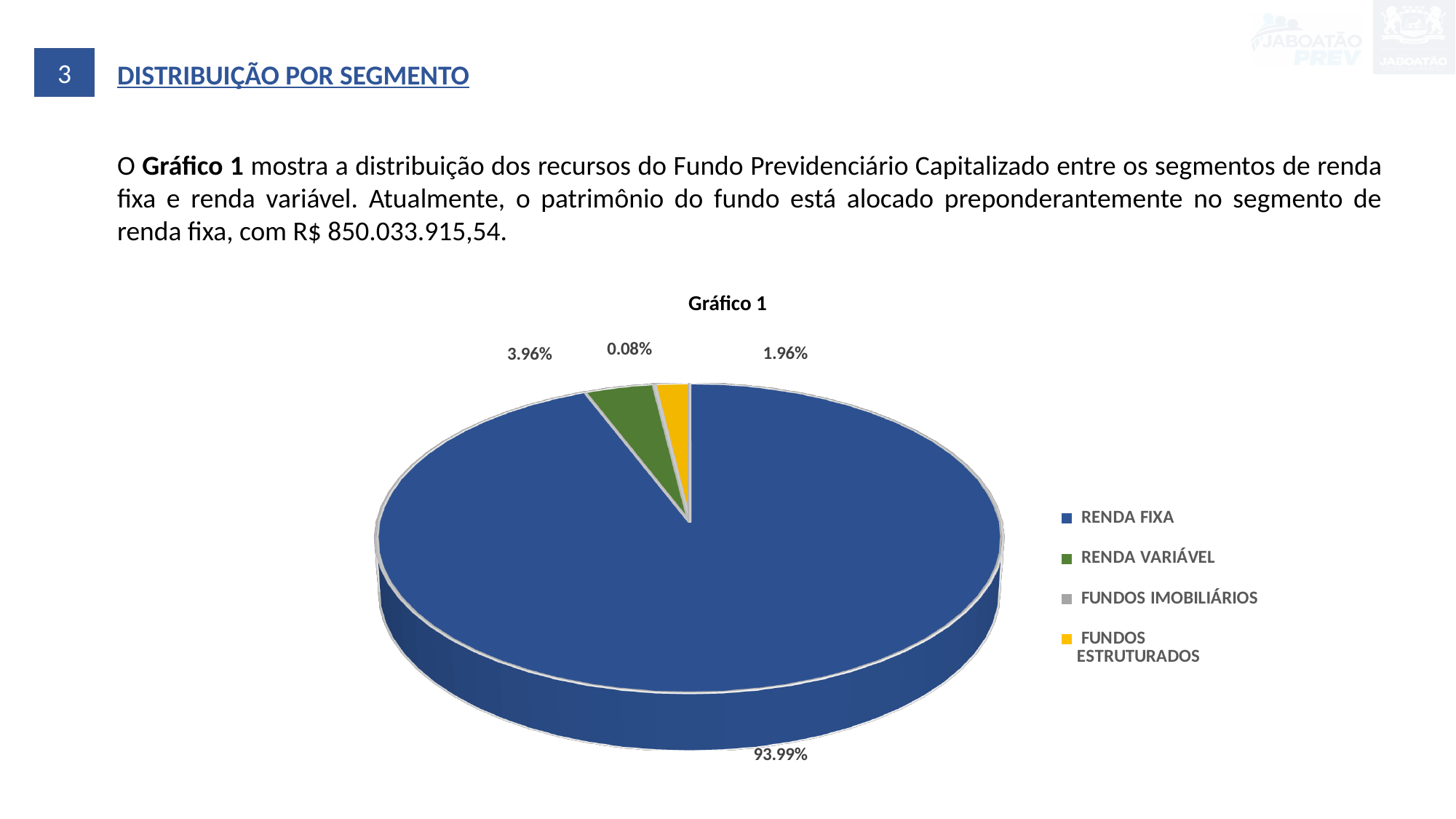
In Gráfico 1, which is larger: RENDA VARIÁVEL or FUNDOS ESTRUTURADOS? RENDA VARIÁVEL What share of the pie does RENDA FIXA hold in Gráfico 1? 93.99% What share of the pie does FUNDOS ESTRUTURADOS hold in Gráfico 1? 1.96% What kind of chart is Gráfico 1? pie chart What share of the pie does RENDA VARIÁVEL hold in Gráfico 1? 3.96% What is the title of the chart on the slide? Gráfico 1 Which segment has the smallest slice in Gráfico 1? FUNDOS IMOBILIÁRIOS What colour is the RENDA FIXA slice in Gráfico 1? blue Which segment has the largest slice in Gráfico 1? RENDA FIXA In Gráfico 1, what is the difference between the RENDA VARIÁVEL share and the FUNDOS ESTRUTURADOS share? 2.00% How many segments are shown in Gráfico 1? 4